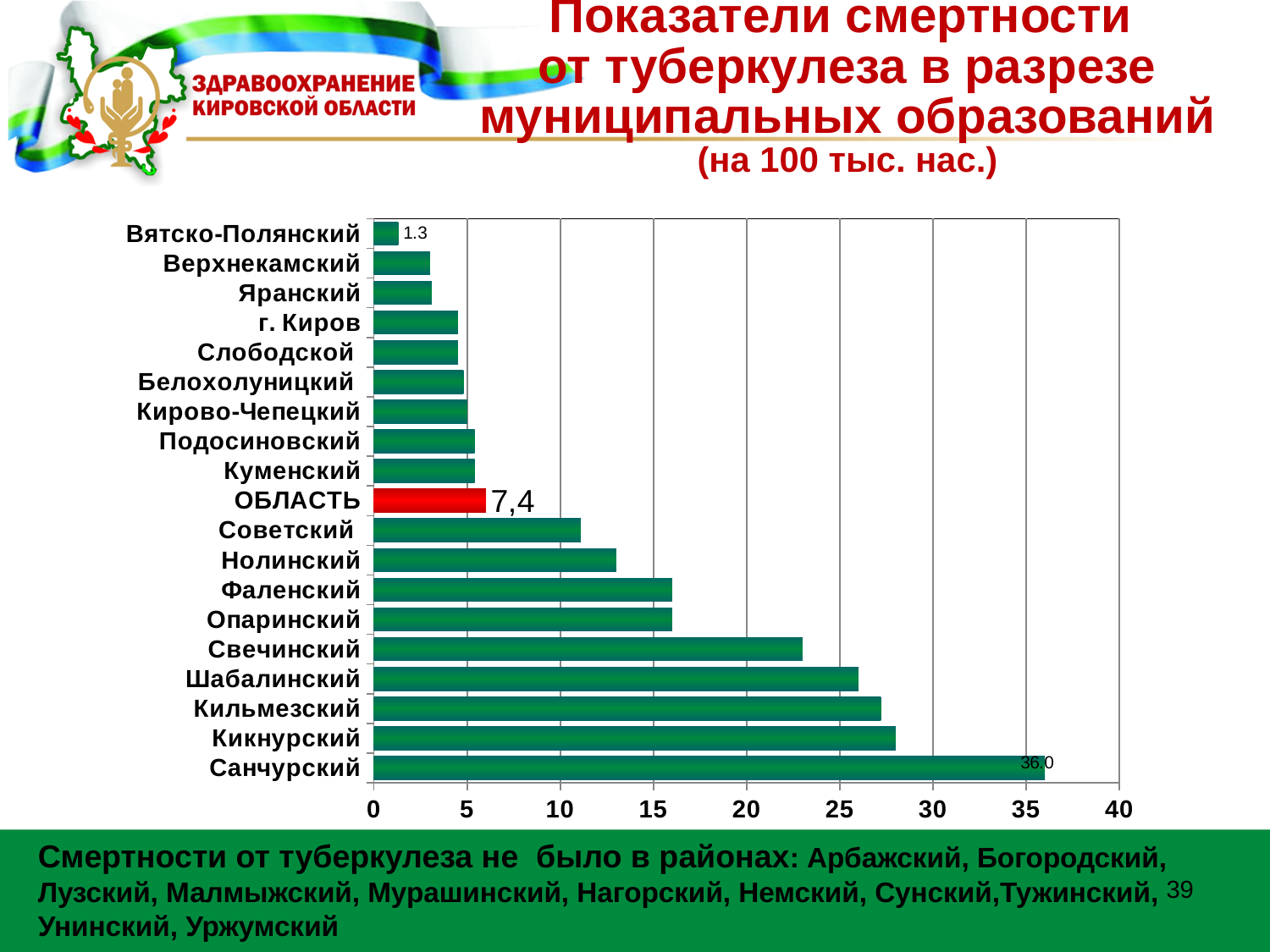
What is the value for Вятско-Полянский? 1.3 What is the value for ОБЛАСТЬ? 7,4 Which category has the lowest value? Вятско-Полянский What is the value for Санчурский? 36.0 What is the difference between the values for Санчурский and Вятско-Полянский? 34.7 What colour is the bar for ОБЛАСТЬ? red Is the value for Кикнурский greater or less than 30? less How many categories are shown on the chart? 19 What kind of chart is shown on the slide? bar chart Is the value for Свечинский greater or less than 20? greater Which is larger, the value for Свечинский or the value for Нолинский? Свечинский Which category has the highest value? Санчурский